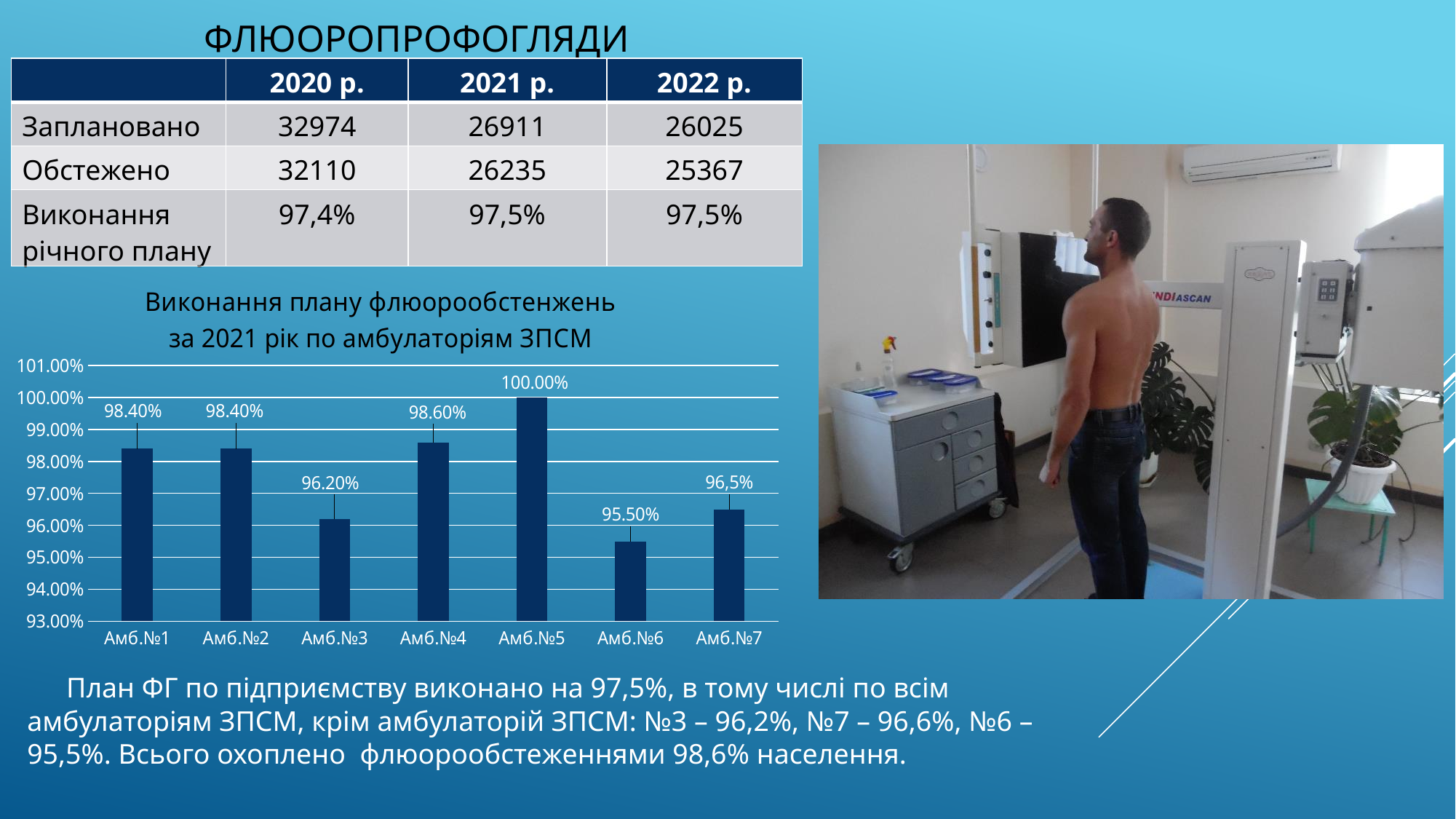
Is the value for Амб.№1 greater or less than 97.00%? greater What type of chart is shown on the slide? bar chart Which category has the lowest value in the chart? Амб.№6 What is the title of the chart? Виконання плану флюорообстенжень за 2021 рік по амбулаторіям ЗПСМ What is the value for Амб.№5 in the chart? 100.00% What is the value for Амб.№7 in the chart? 96,5% What is the value for Амб.№3 in the chart? 96.20% What is the difference between the values for Амб.№5 and Амб.№6? 4.50% Which category has the highest value in the chart? Амб.№5 Which is larger, the value for Амб.№4 or the value for Амб.№3? Амб.№4 What is the value for Амб.№6 in the chart? 95.50% How many categories are shown on the x axis of the chart? 7